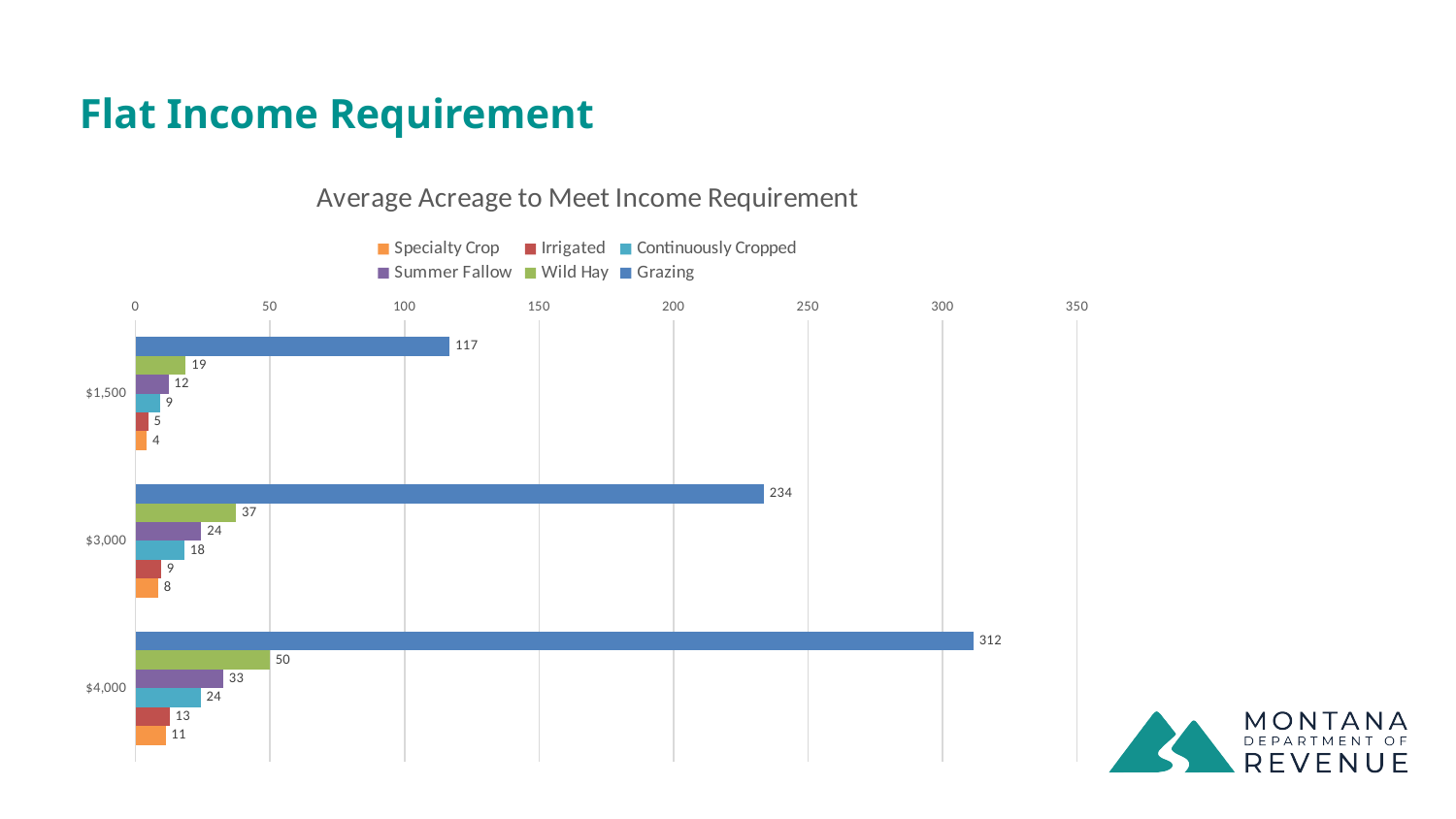
Which income category has the highest Grazing value? $4,000 What is the Continuously Cropped value for $4,000? 24 How many series does the legend list? 6 What is the title of the chart? Average Acreage to Meet Income Requirement What is the Grazing value for $4,000? 312 Which income category has the lowest Irrigated value? $1,500 What is the Specialty Crop value for $1,500? 4 Which is larger for $3,000: Summer Fallow or Continuously Cropped? Summer Fallow What is the Wild Hay value for $3,000? 37 How many income categories are shown on the chart? 3 What kind of chart is shown on the slide? Bar chart What is the difference between the Grazing values for $4,000 and $3,000? 78